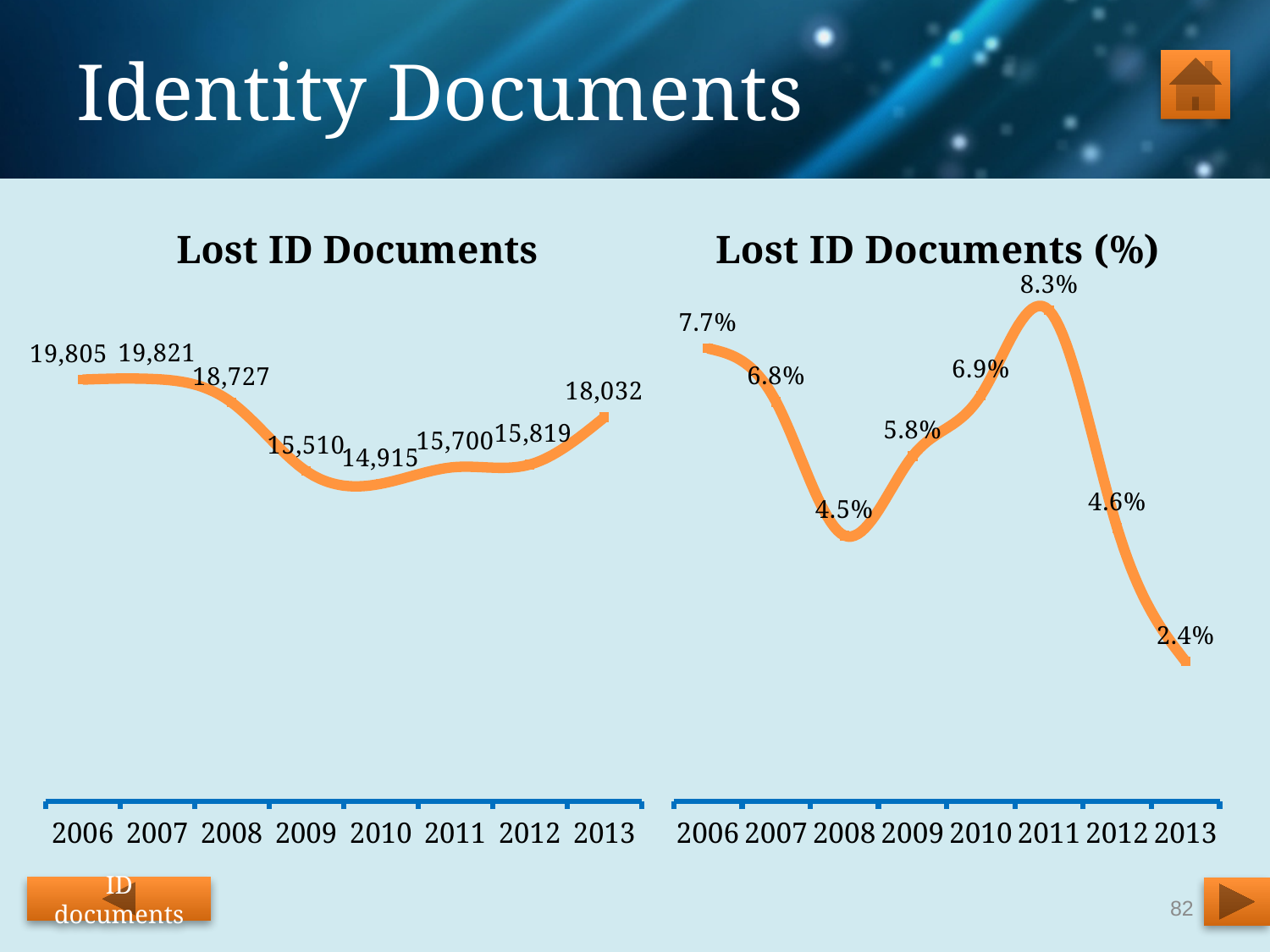
In the 'Lost ID Documents (%)' chart, which year has the lowest value? 2013 In the 'Lost ID Documents (%)' chart, what is the difference between the 2011 and 2012 values? 3.7% In the 'Lost ID Documents' chart, what is the value for 2013? 18,032 In the 'Lost ID Documents (%)' chart, what is the value for 2011? 8.3% In the 'Lost ID Documents (%)' chart, what is the value for 2008? 4.5% In the 'Lost ID Documents' chart, how many years are plotted? 8 In the 'Lost ID Documents' chart, what is the value for 2010? 14,915 In the 'Lost ID Documents' chart, which year has the highest value? 2007 In the 'Lost ID Documents' chart, which year has the lowest value? 2010 In the 'Lost ID Documents' chart, what is the difference between the 2008 and 2009 values? 3,217 What type of chart is the 'Lost ID Documents (%)' chart? Line chart In the 'Lost ID Documents (%)' chart, which is larger, the value for 2006 or the value for 2010? 2006